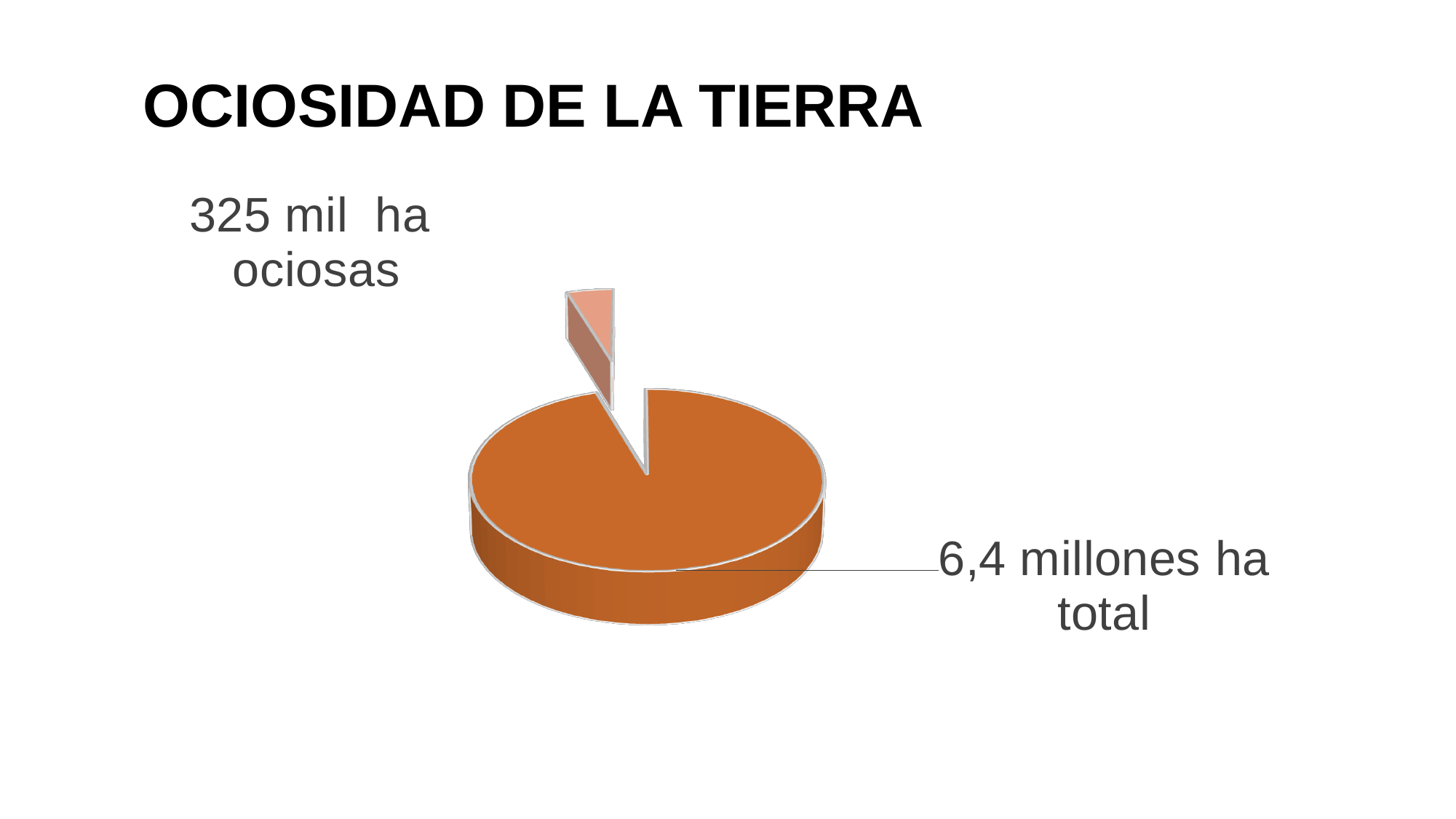
How many slices does the pie chart have? 2 What label is attached to the small exploded slice of the pie chart? 325 mil ha ociosas Which slice of the pie chart is the largest? 6,4 millones ha total What kind of chart is shown on the slide? pie chart Which slice of the pie chart is larger, the one labelled '325 mil ha ociosas' or the one labelled '6,4 millones ha total'? 6,4 millones ha total What is the title of the slide containing the pie chart? OCIOSIDAD DE LA TIERRA Which slice of the pie chart is the smallest? 325 mil ha ociosas Which slice of the pie chart is pulled out (exploded) from the rest of the pie? 325 mil ha ociosas What label is attached to the large slice of the pie chart? 6,4 millones ha total